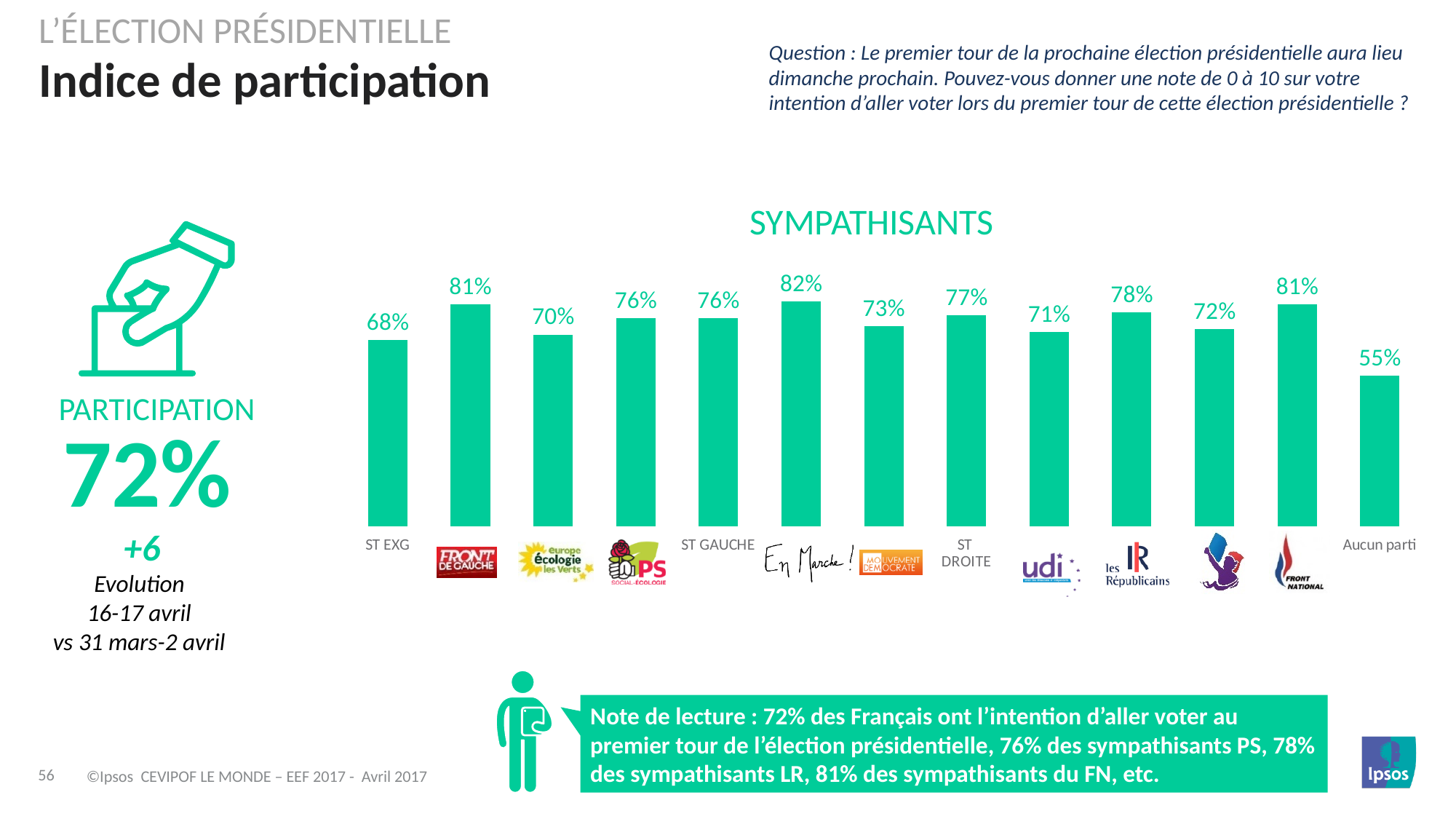
What is the difference between the Les Républicains bar and the UDI bar in the SYMPATHISANTS chart? 7 percentage points What is the value for ST EXG in the SYMPATHISANTS chart? 68% How many bars are shown in the SYMPATHISANTS chart? 13 What type of chart is shown under the title SYMPATHISANTS? bar chart What is the value for ST DROITE in the SYMPATHISANTS chart? 77% What is the value for the En Marche! bar in the SYMPATHISANTS chart? 82% Which category has the lowest value in the SYMPATHISANTS chart? Aucun parti What overall participation percentage is shown on the left of the slide? 72% Which category has the highest value in the SYMPATHISANTS chart? En Marche! What is the value for Aucun parti in the SYMPATHISANTS chart? 55% Which is larger in the SYMPATHISANTS chart: the Front National bar or the Mouvement Démocrate bar? Front National What is the difference between the ST GAUCHE value and the Aucun parti value in the SYMPATHISANTS chart? 21 percentage points